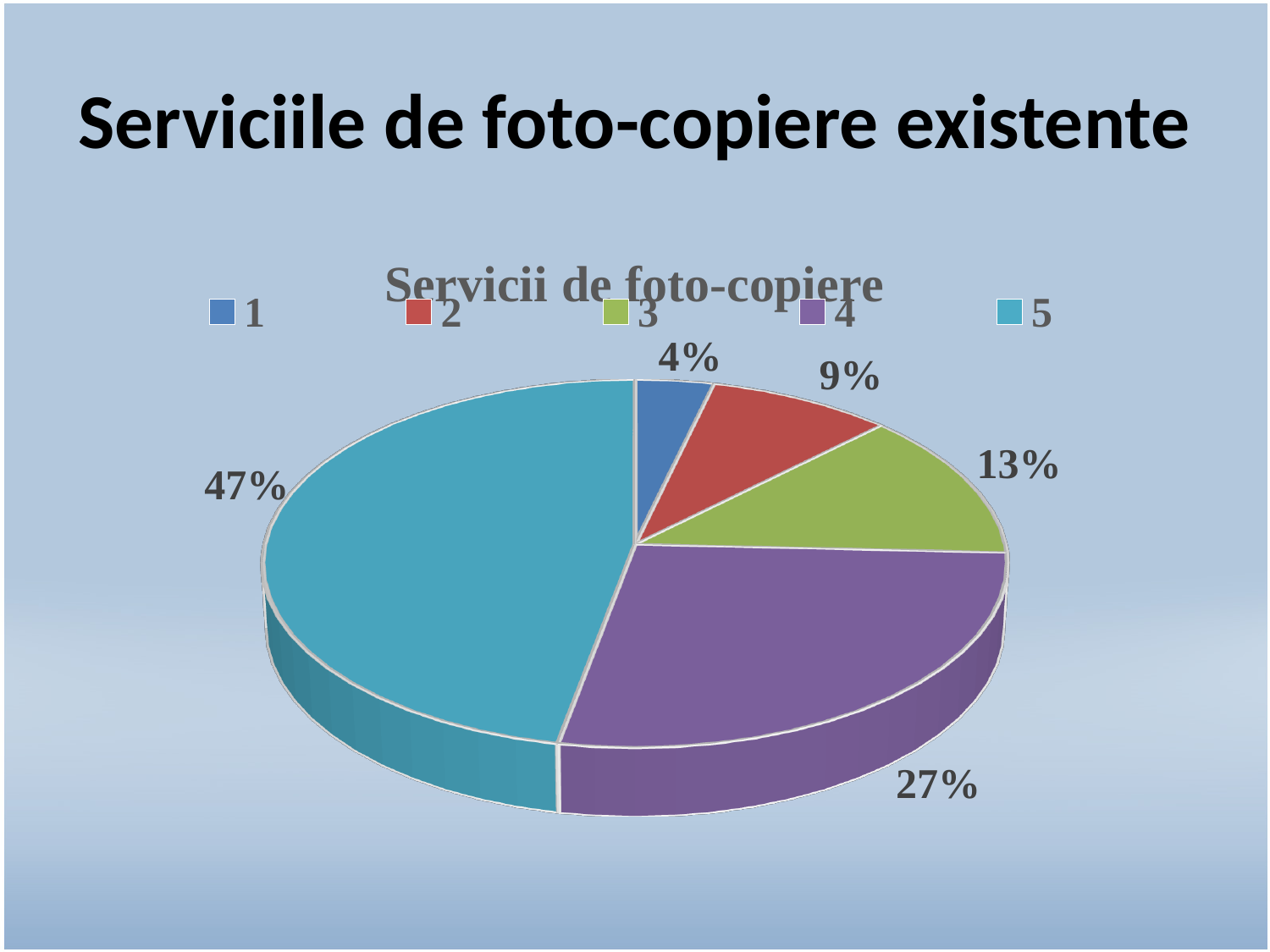
What is the value for category 2? 9% What share of the pie does category 4 have? 27% What is the chart's title? Servicii de foto-copiere Which category has the smallest slice? 1 What share of the pie does category 5 have? 47% What kind of chart is shown on the slide? pie chart Which category has the largest slice? 5 What is the value for category 1? 4% How many categories does the legend list? 5 Which is larger, the share of category 3 or category 2? category 3 What is the difference between the shares of category 5 and category 4? 20% What is the value for category 3? 13%